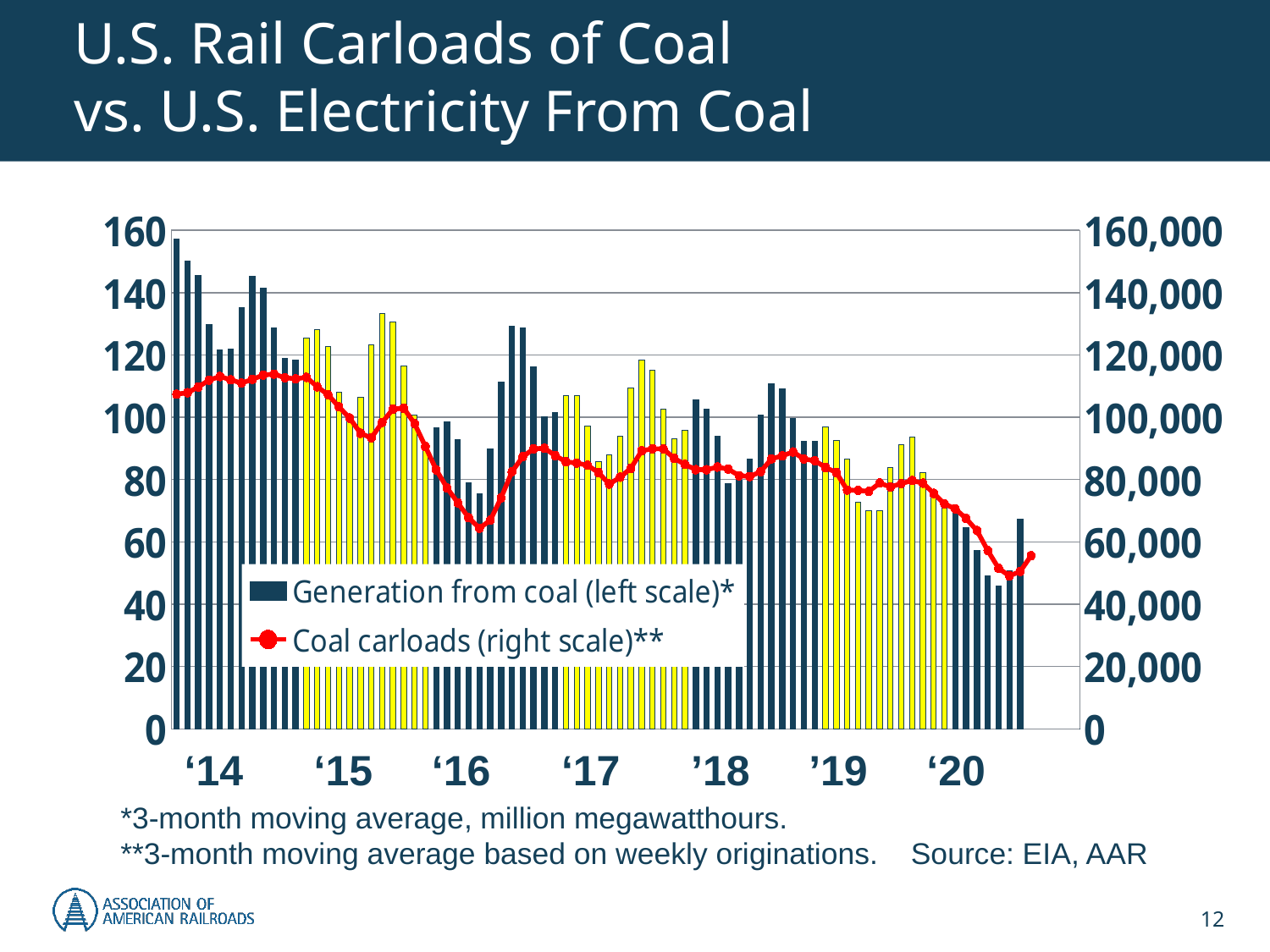
Is the last generation from coal bar in '20 greater or less than 80? less Overall, do coal carloads rise or fall from '14 to '20? fall What is the highest value shown on the right axis? 160,000 How many year labels are shown on the x axis? 7 Is the coal carloads value at the end of '20 greater or less than 60,000? less Which series is plotted on the right scale according to the legend? Coal carloads How many series does the legend list? 2 Is the coal carloads value at the start of '14 greater or less than 100,000? greater What is the highest value shown on the left axis? 160 Which series is plotted on the left scale according to the legend? Generation from coal What kind of chart is shown on the slide? A combined bar and line chart